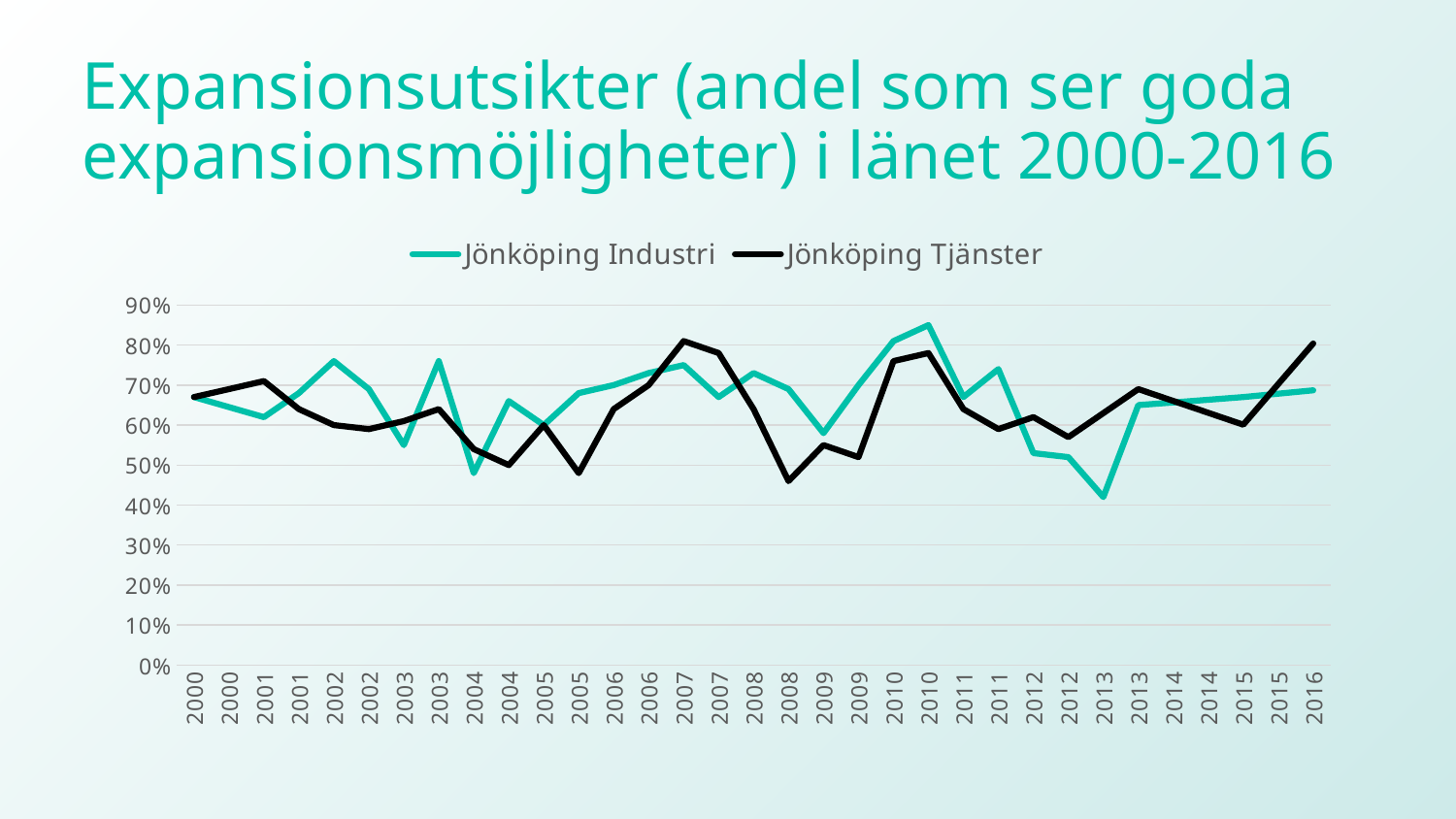
What are the two series named in the legend? Jönköping Industri and Jönköping Tjänster What kind of chart is shown on the slide? line chart At the first 2013 point, which series has the larger value, Jönköping Industri or Jönköping Tjänster? Jönköping Tjänster How many series does the legend list? 2 In which year does the Jönköping Industri line reach its lowest value? 2013 Is the highest value of Jönköping Industri (in 2010) greater or less than 80%? greater In which year does the Jönköping Industri line reach its highest value? 2010 Is the lowest value of Jönköping Tjänster (in 2008) greater or less than 50%? less At the second 2008 point, which series has the larger value, Jönköping Industri or Jönköping Tjänster? Jönköping Industri Which colour is the Jönköping Tjänster line drawn in? black Is the lowest value of Jönköping Industri (in 2013) greater or less than 50%? less Does the Jönköping Tjänster line rise or fall from 2015 to 2016? rise